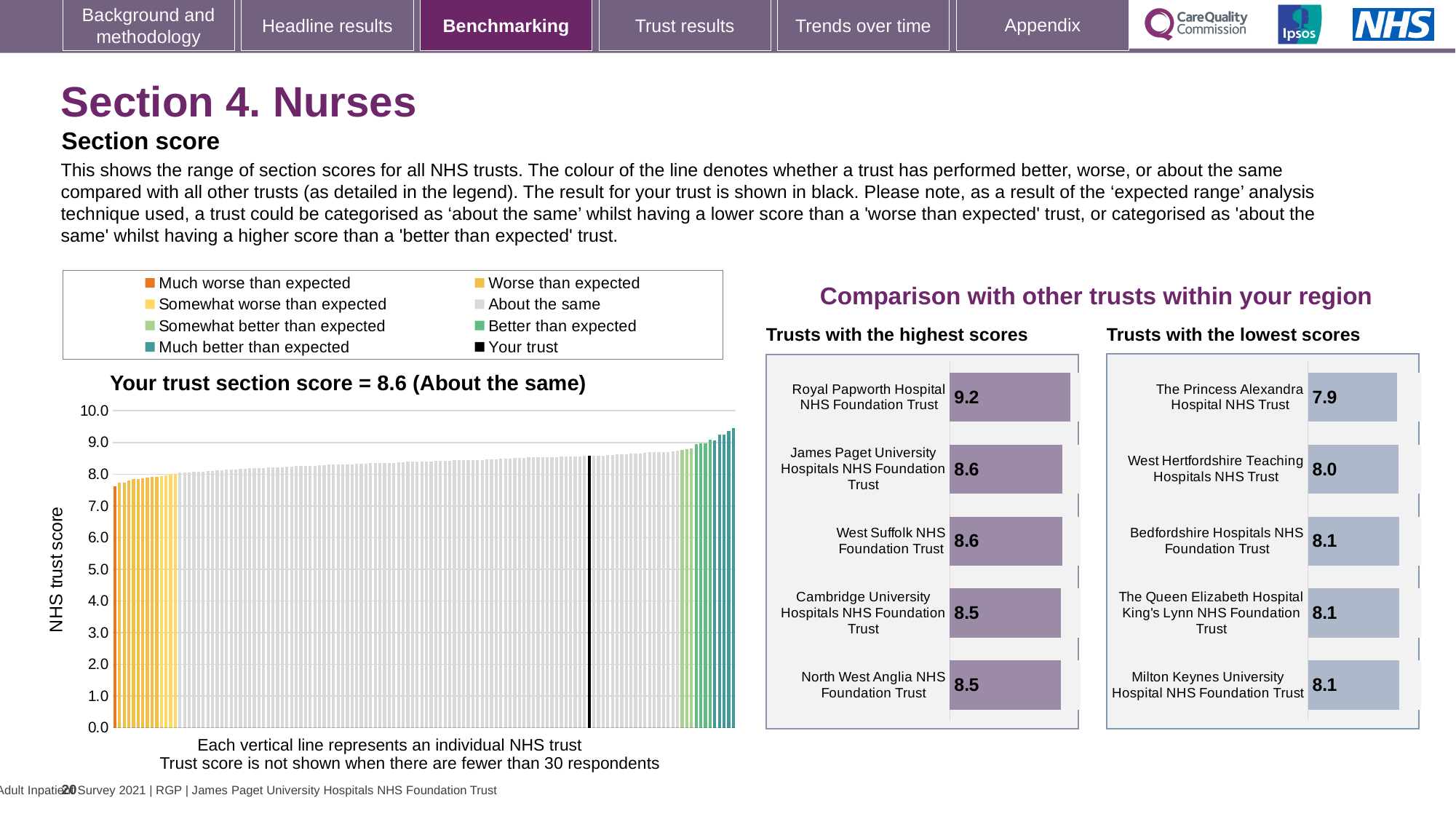
In the 'Your trust section score' chart, what is the label on the vertical axis? NHS trust score In the 'Trusts with the lowest scores' chart, what is the score for West Hertfordshire Teaching Hospitals NHS Trust? 8.0 In the 'Your trust section score' chart, is the value of the shortest bar greater or less than 8.0? less In the 'Trusts with the highest scores' chart, what is the difference between the scores of Royal Papworth Hospital NHS Foundation Trust and North West Anglia NHS Foundation Trust? 0.7 In the 'Trusts with the highest scores' chart, what is the score for Royal Papworth Hospital NHS Foundation Trust? 9.2 What kind of chart is the 'Your trust section score' chart? Bar chart In the 'Trusts with the highest scores' chart, how many trusts are shown? 5 In the 'Trusts with the lowest scores' chart, which trust has the lowest score? The Princess Alexandra Hospital NHS Trust In the 'Trusts with the lowest scores' chart, which is larger: the score for Bedfordshire Hospitals NHS Foundation Trust or The Princess Alexandra Hospital NHS Trust? Bedfordshire Hospitals NHS Foundation Trust In the 'Your trust section score' chart, how many entries does the legend list? 8 In the 'Your trust section score' chart, what is the section score for your trust? 8.6 In the 'Your trust section score' chart, is the value of the tallest bar greater or less than 9.0? greater